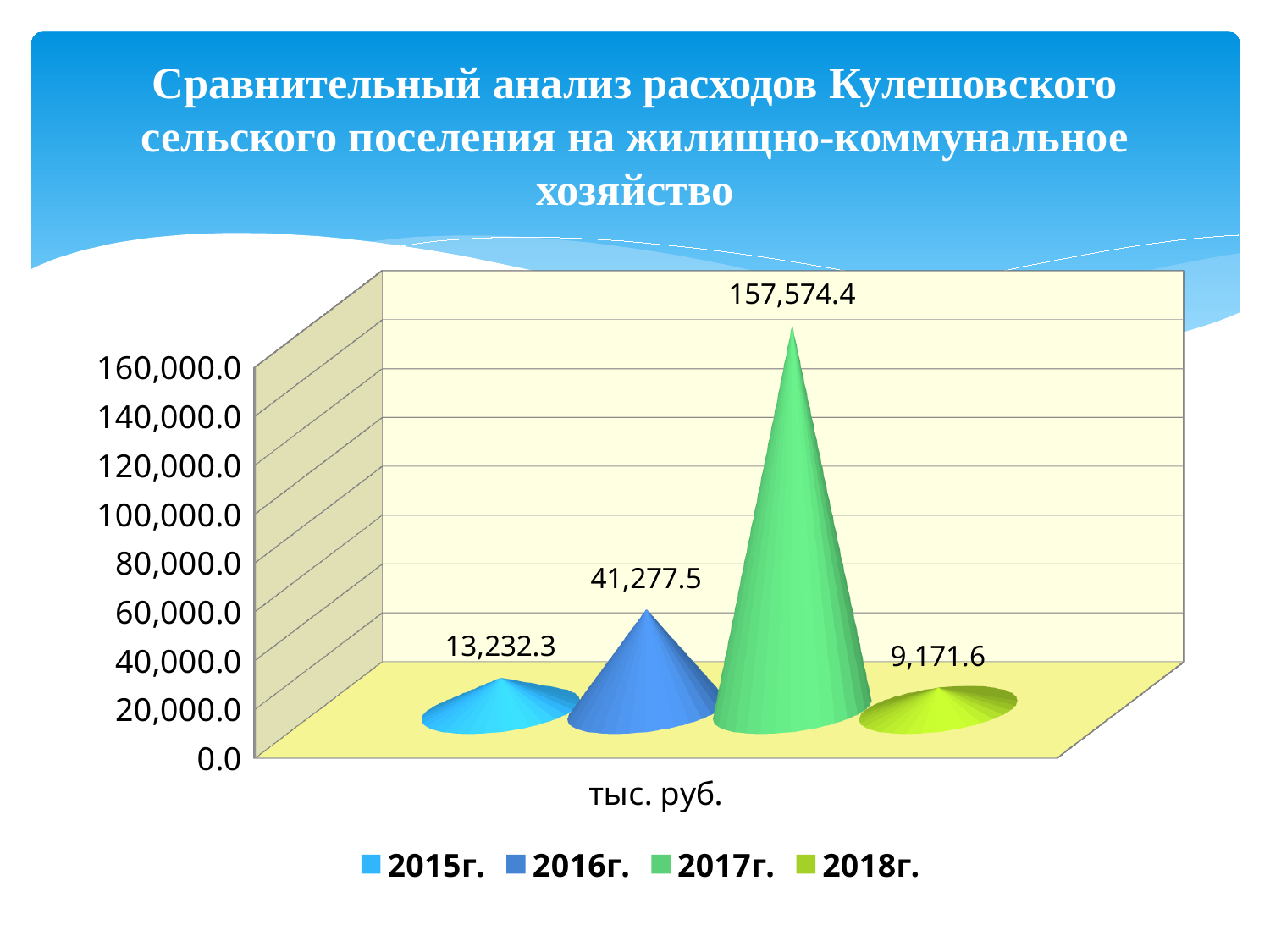
What is the value for 2015г.? 13,232.3 Which is larger, the value for 2016г. or the value for 2015г.? 2016г. What is the difference between the values for 2017г. and 2016г.? 116,296.9 What is the value for 2018г.? 9,171.6 What is the value for 2016г.? 41,277.5 Is the value for 2017г. greater or less than 140,000.0? greater Which year has the lowest value? 2018г. How many series does the legend list? 4 What is the difference between the values for 2015г. and 2018г.? 4,060.7 What unit label is shown under the chart's category axis? тыс. руб. Which year has the highest value? 2017г. What is the value for 2017г.? 157,574.4